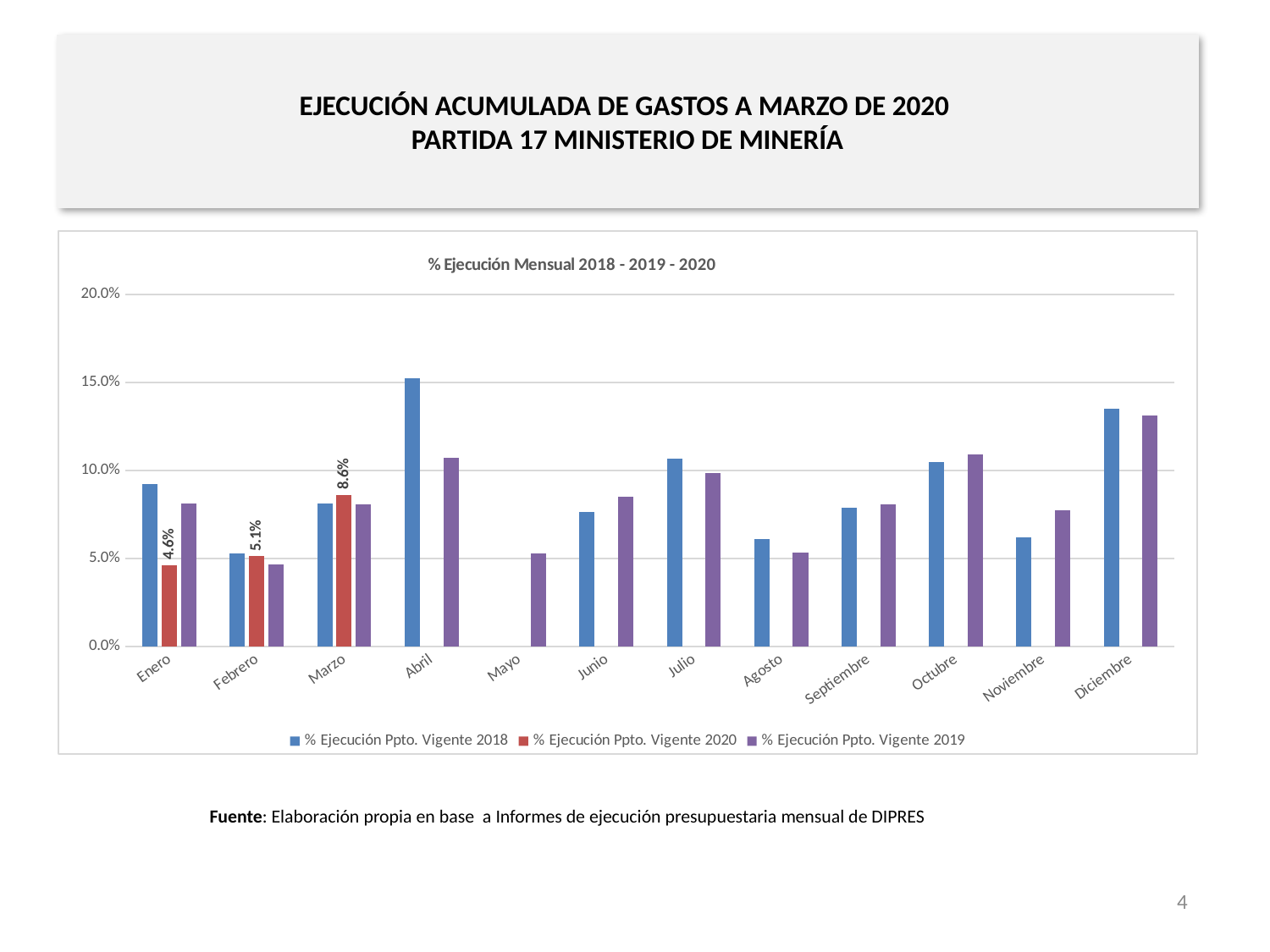
How many series does the legend list? 3 What is the value for Marzo in the % Ejecución Ppto. Vigente 2020 series? 8.6% What is the value for Enero in the % Ejecución Ppto. Vigente 2020 series? 4.6% For Abril, which series has the larger value: % Ejecución Ppto. Vigente 2018 or % Ejecución Ppto. Vigente 2019? % Ejecución Ppto. Vigente 2018 Which month has the lowest value in the % Ejecución Ppto. Vigente 2020 series? Enero Is the value for Abril in the % Ejecución Ppto. Vigente 2018 series greater or less than 10.0%? greater What is the value for Febrero in the % Ejecución Ppto. Vigente 2020 series? 5.1% Is the value for Mayo in the % Ejecución Ppto. Vigente 2019 series greater or less than 10.0%? less What type of chart is shown on the slide? bar chart Which month has the highest value in the % Ejecución Ppto. Vigente 2020 series? Marzo What is the difference between the Marzo and Enero values in the % Ejecución Ppto. Vigente 2020 series? 4.0% How many months are shown on the x axis? 12